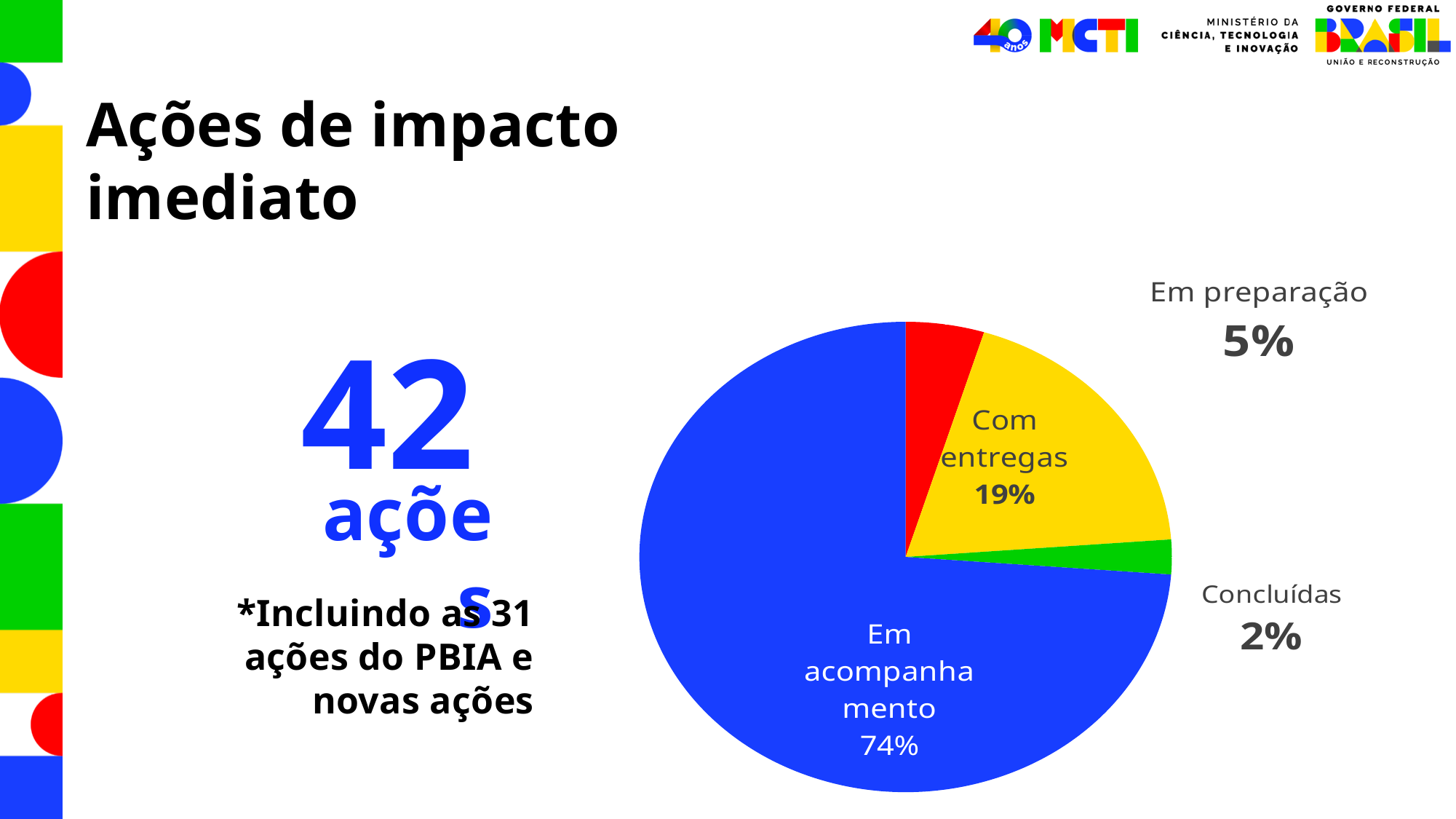
How many categories are shown in the pie chart? 4 What kind of chart is shown on the slide? pie chart What share of the pie does "Em preparação" represent? 5% Which category has the smallest slice of the pie? Concluídas What colour is the "Concluídas" slice of the pie? green What share of the pie does "Em acompanhamento" represent? 74% Which is larger, the share for "Em preparação" or the share for "Concluídas"? Em preparação What share of the pie does "Com entregas" represent? 19% What share of the pie does "Concluídas" represent? 2% Which category has the largest slice of the pie? Em acompanhamento What colour is the "Com entregas" slice of the pie? yellow What is the difference in percentage points between "Em acompanhamento" and "Com entregas"? 55